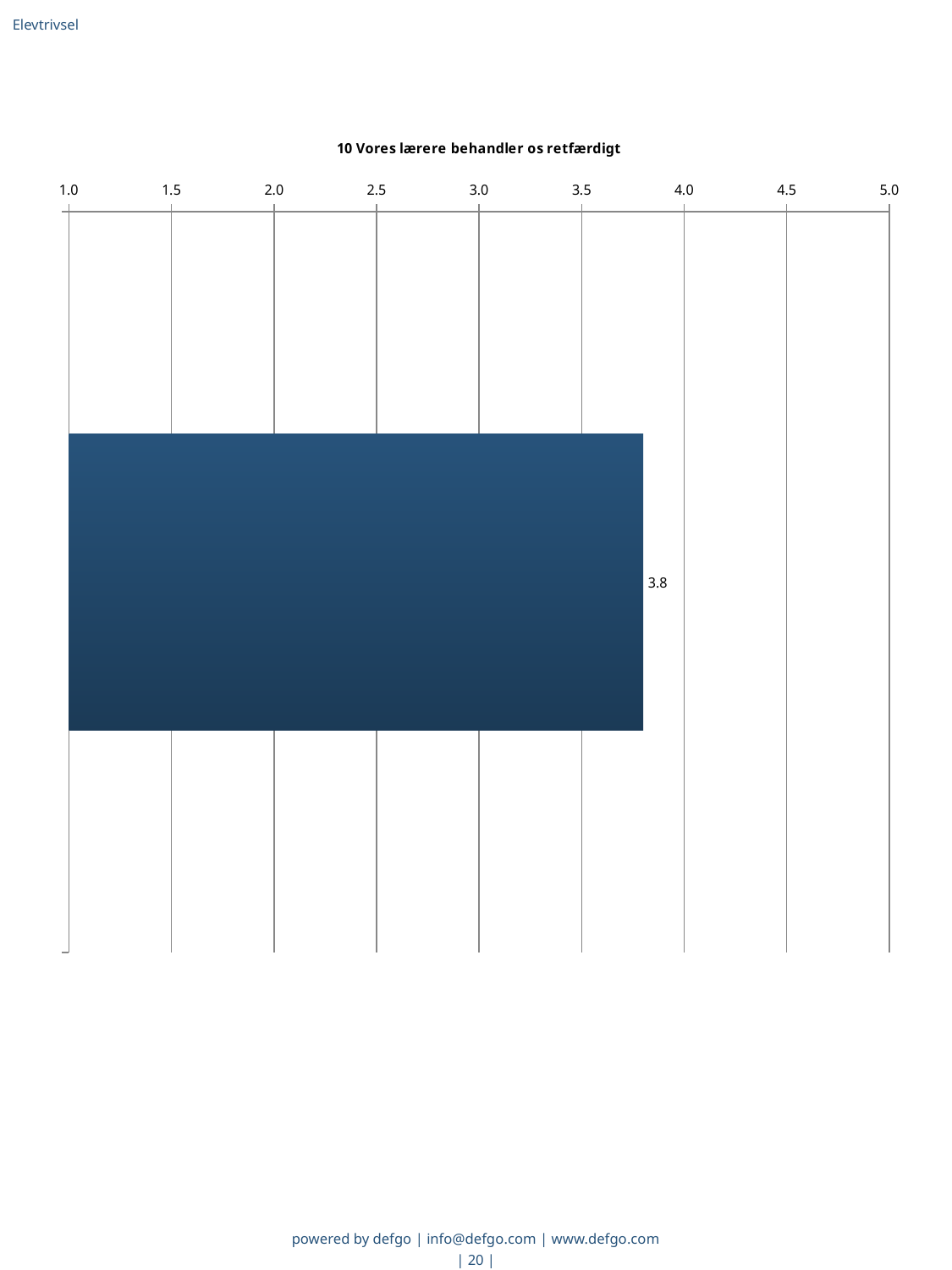
What value is shown by the bar in the chart? 3.8 Is the value of the bar greater or less than 3.5? greater Is the value of the bar greater or less than 4.0? less What is the highest value shown on the chart's axis? 5.0 How many bars are plotted in the chart? 1 What is the title of the chart? 10 Vores lærere behandler os retfærdigt What kind of chart is shown on the slide? bar chart Is the value of the bar greater or less than 3.0? greater